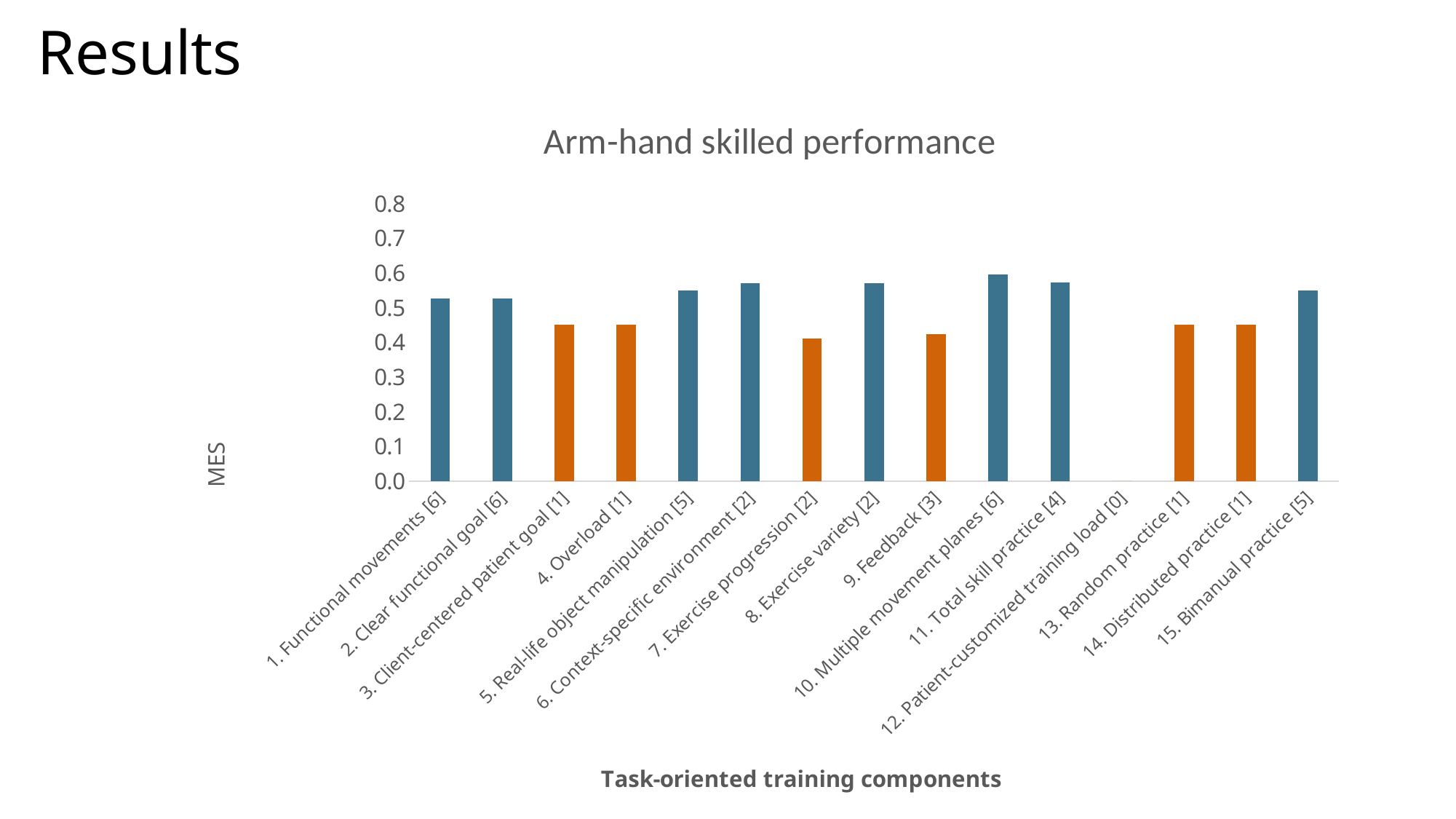
Is the value for 10. Multiple movement planes [6] greater or less than 0.7? less Is the value for 7. Exercise progression [2] greater or less than 0.5? less Which has the larger value: 10. Multiple movement planes [6] or 7. Exercise progression [2]? 10. Multiple movement planes [6] What kind of chart is shown on the slide? bar chart Which category has the tallest bar in the chart? 10. Multiple movement planes [6] Which category has no visible bar in the chart? 12. Patient-customized training load [0] What is the title of the chart? Arm-hand skilled performance Is the value for 1. Functional movements [6] greater or less than 0.5? greater What is the label on the vertical axis of the chart? MES How many task-oriented training components are listed along the x axis? 15 Which has the larger value: 6. Context-specific environment [2] or 9. Feedback [3]? 6. Context-specific environment [2]